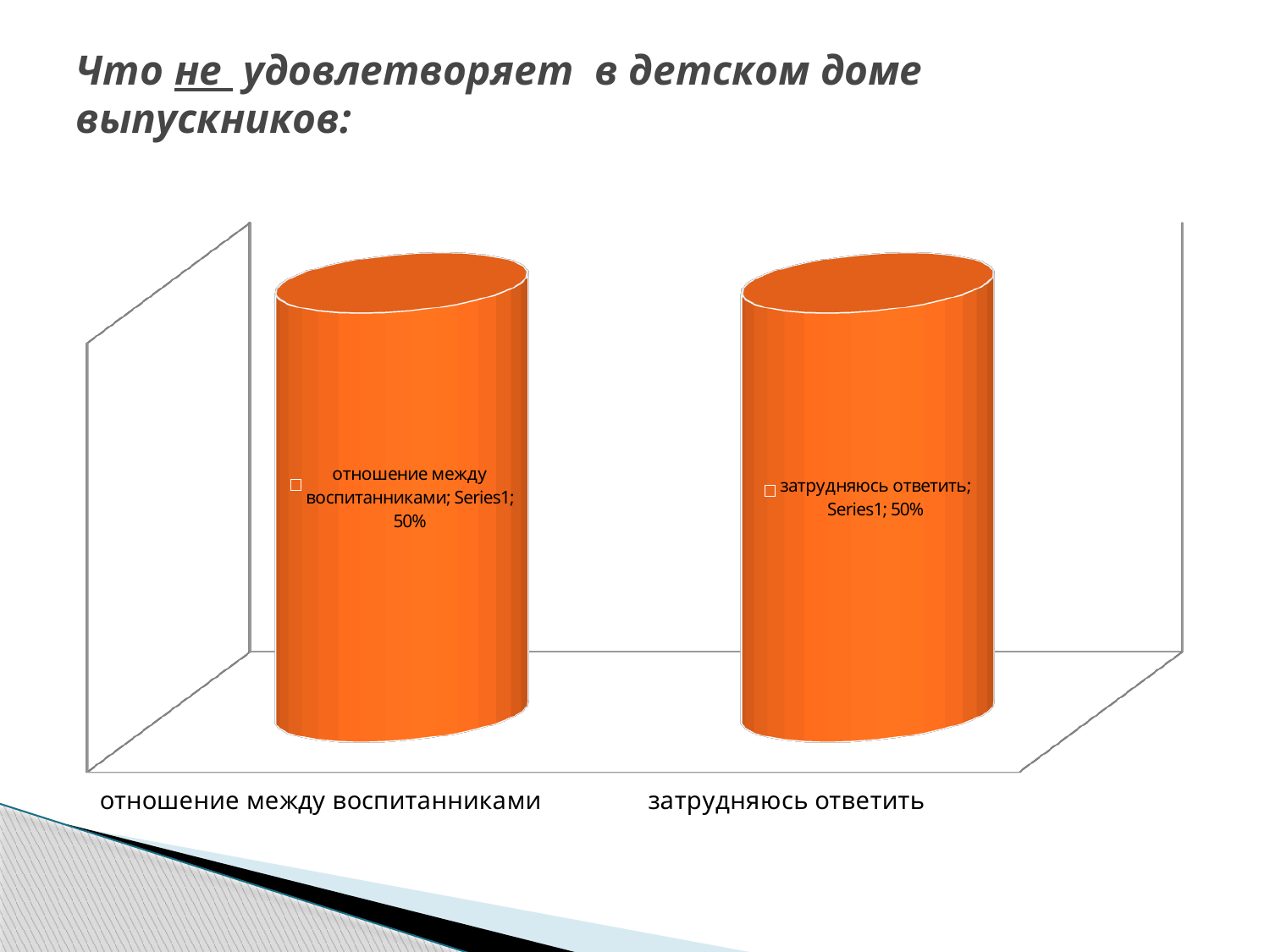
What is the label of the right-hand category on the x axis? затрудняюсь ответить What kind of chart is shown on the slide? Bar chart What is the title of the slide? Что не удовлетворяет в детском доме выпускников: How many categories are shown on the chart? 2 What is the label of the left-hand category on the x axis? отношение между воспитанниками Do the two categories on the chart have the same value or different values? The same value Which series name is shown in the data labels on the chart? Series1 What is the difference between the values for "отношение между воспитанниками" and "затрудняюсь ответить"? 0% What colour are the bars on the chart? Orange What is the value for "затрудняюсь ответить"? 50% What is the value for "отношение между воспитанниками"? 50%